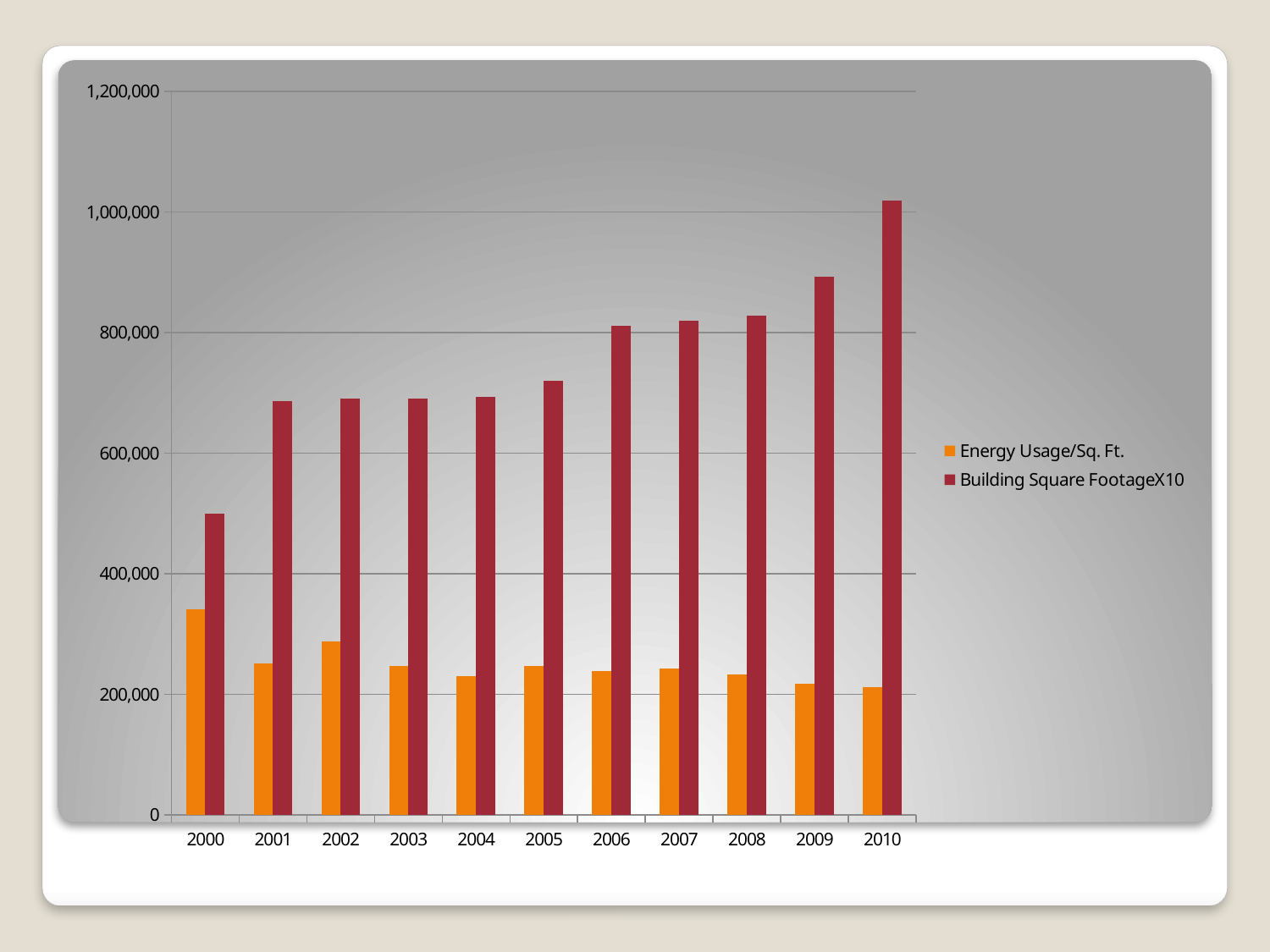
In which year is Building Square FootageX10 highest? 2010 How many years are shown on the x axis? 11 In which year is Building Square FootageX10 lowest? 2000 How many series does the legend list? 2 Is the value for Building Square FootageX10 in 2010 greater or less than 1,000,000? greater In which year is Energy Usage/Sq. Ft. highest? 2000 What kind of chart is shown on the slide? Bar chart Is the value for Building Square FootageX10 in 2000 greater or less than 600,000? less Which year has the larger Energy Usage/Sq. Ft. value, 2001 or 2002? 2002 Is the value for Energy Usage/Sq. Ft. in 2000 greater or less than 400,000? less Does Building Square FootageX10 generally rise or fall from 2000 to 2010? Rise Which year has the larger Building Square FootageX10 value, 2008 or 2009? 2009